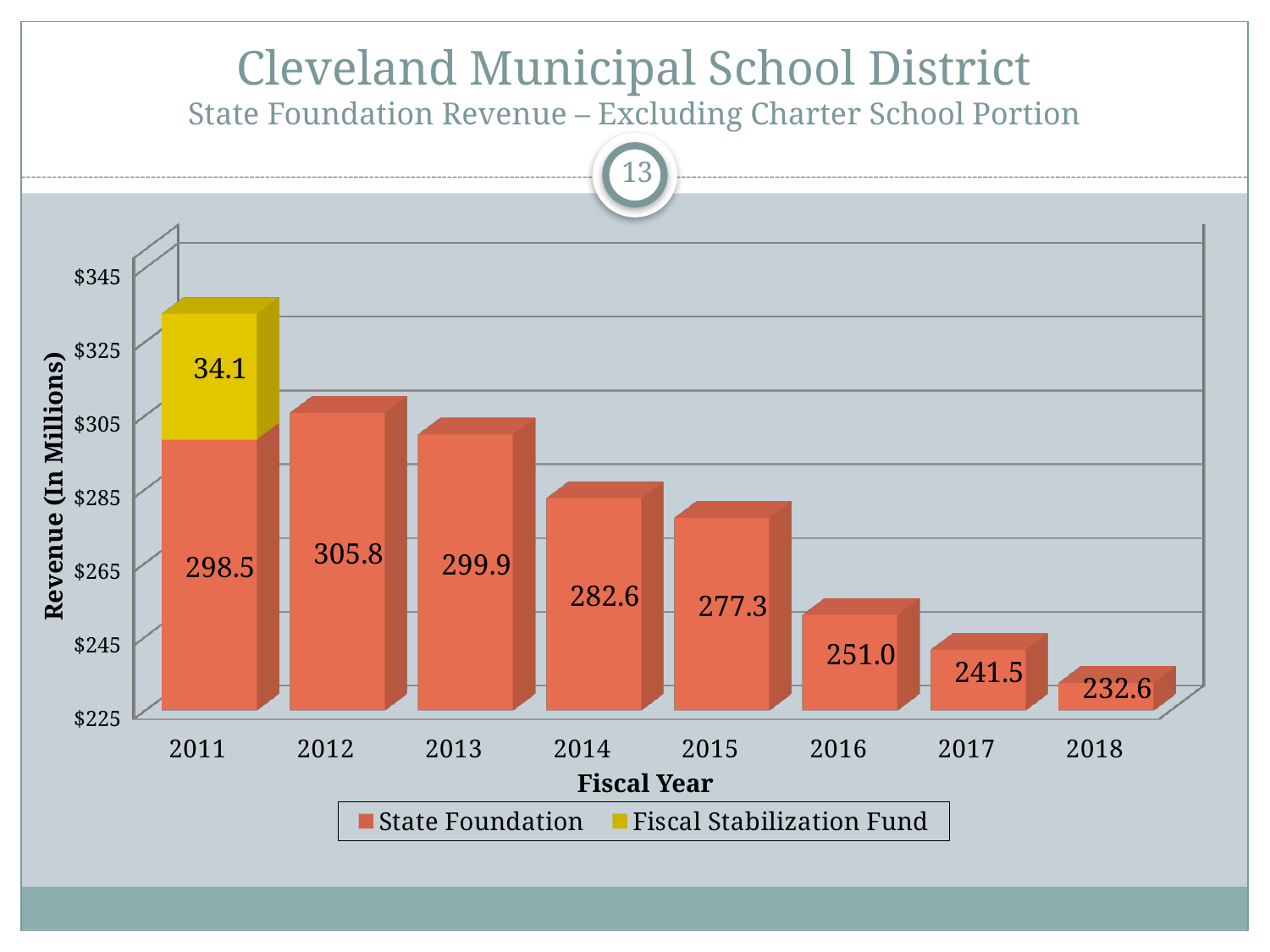
How many series does the legend list? 2 Which fiscal year has the lowest State Foundation revenue? 2018 What is the label of the y axis? Revenue (In Millions) What is the difference between the State Foundation revenue in 2012 and in 2018? 73.2 What is the State Foundation revenue for fiscal year 2014? 282.6 How many fiscal years are shown on the x axis? 8 Is the State Foundation revenue higher in 2013 or in 2015? 2013 Which fiscal year has the highest State Foundation revenue? 2012 Is the State Foundation value for 2016 greater or less than $245? greater What is the total of the stacked bar for 2011 (State Foundation plus Fiscal Stabilization Fund)? 332.6 What kind of chart is shown on the slide? bar chart What is the Fiscal Stabilization Fund value shown for 2011? 34.1